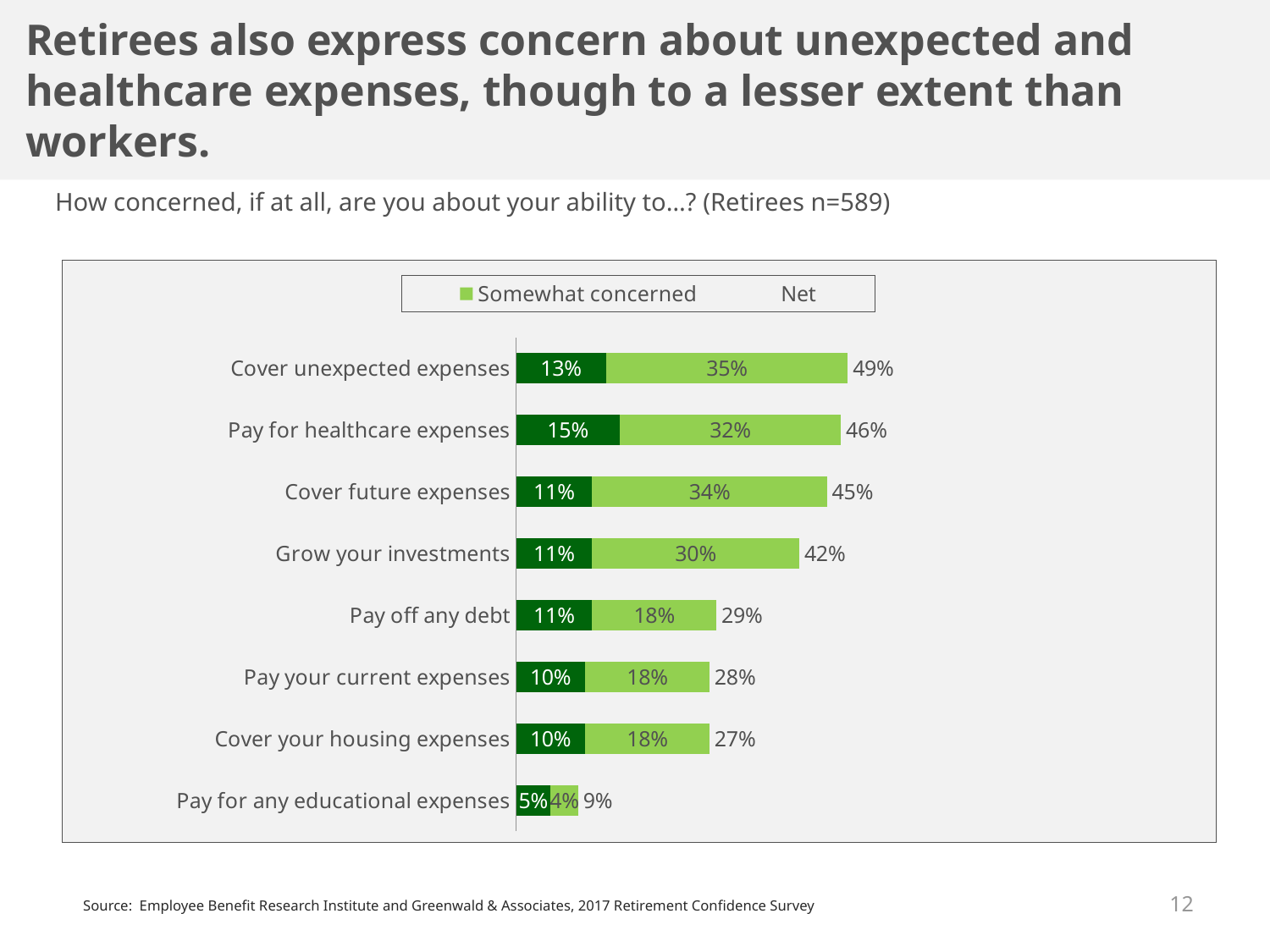
What is the 'Somewhat concerned' value for 'Grow your investments'? 30% Do the Net values rise or fall going down the chart from top to bottom? Fall What is the difference between the Net values for 'Cover unexpected expenses' and 'Pay off any debt'? 20% What is the 'Somewhat concerned' value for 'Cover unexpected expenses'? 35% What type of chart is shown on the slide? Stacked bar chart What is the Net value for 'Cover your housing expenses'? 27% Which category has the lowest Net value? Pay for any educational expenses Which category has the highest Net value? Cover unexpected expenses Which has a larger 'Somewhat concerned' value: 'Cover future expenses' or 'Grow your investments'? Cover future expenses How many categories (items) are shown in the chart? 8 What is the sample size of retirees stated in the chart's question text? n=589 What is the Net value for 'Pay for healthcare expenses'? 46%